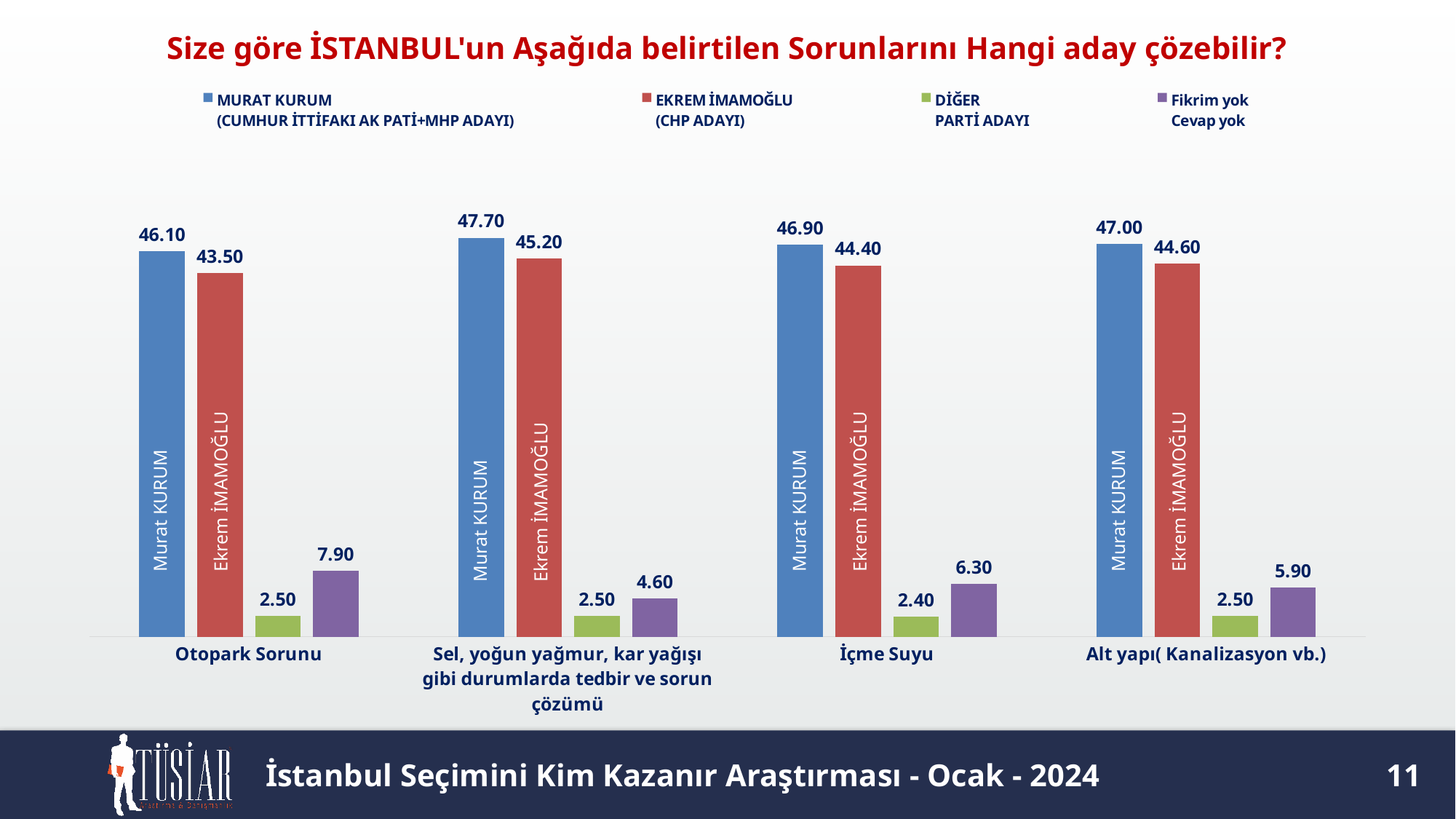
What is the value for Diğer Parti Adayı in the İçme Suyu category? 2.40 In which category does Murat Kurum have the highest value? Sel, yoğun yağmur, kar yağışı gibi durumlarda tedbir ve sorun çözümü Which is larger in the İçme Suyu category: Murat Kurum or Ekrem İmamoğlu? Murat Kurum How many categories are shown on the x axis? 4 What kind of chart is shown on the slide? Bar chart What is the difference between Murat Kurum and Ekrem İmamoğlu in the Otopark Sorunu category? 2.60 What is the value for Fikrim yok Cevap yok in the Alt yapı( Kanalizasyon vb.) category? 5.90 What is the value for Murat Kurum in the Otopark Sorunu category? 46.10 How many series does the legend list? 4 What is the value for Ekrem İmamoğlu in the İçme Suyu category? 44.40 Which colour represents Ekrem İmamoğlu (CHP Adayı) in the chart? Red In which category does Fikrim yok Cevap yok have the lowest value? Sel, yoğun yağmur, kar yağışı gibi durumlarda tedbir ve sorun çözümü